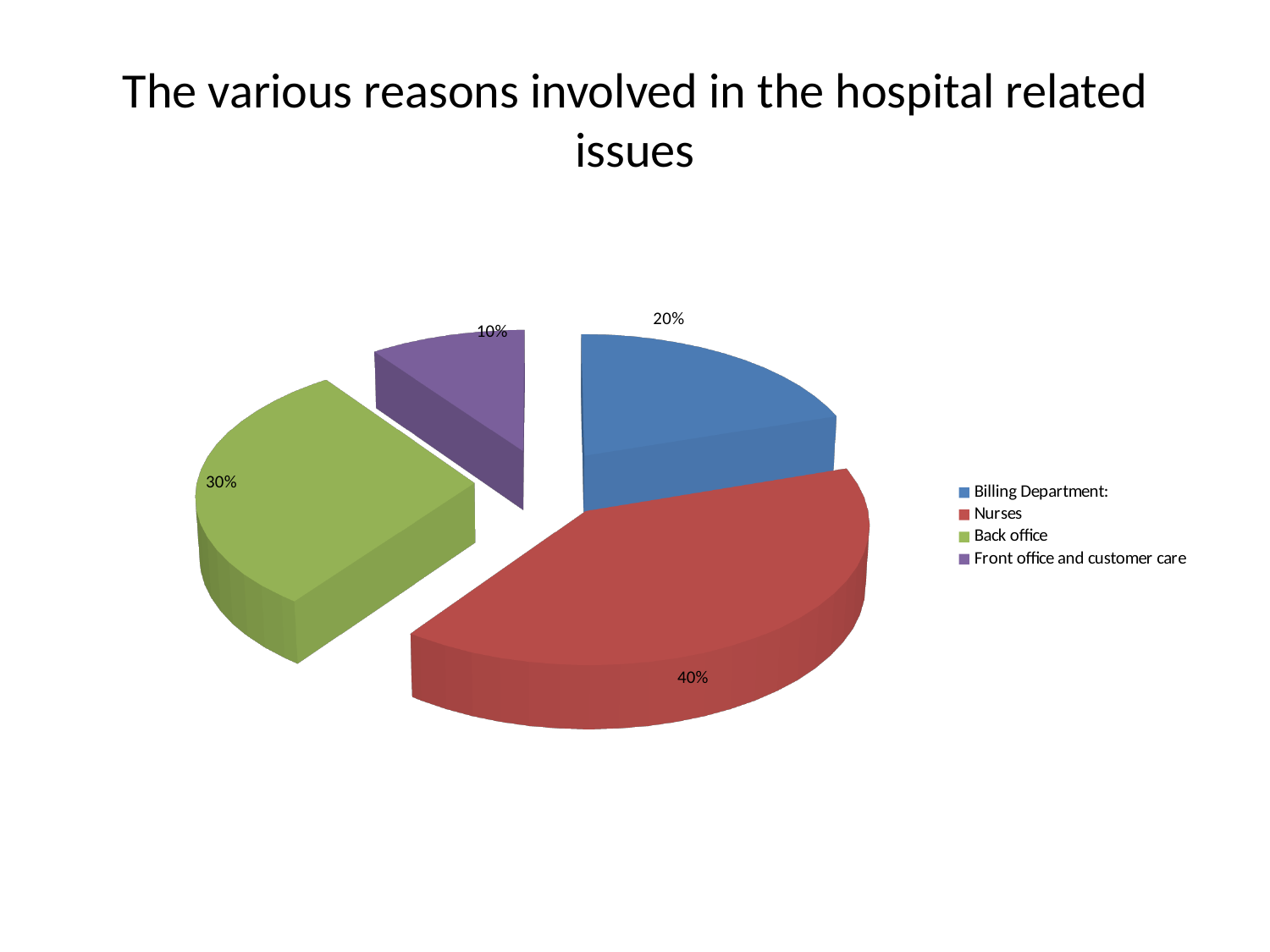
Which category has the largest slice of the pie? Nurses What share of the pie does Billing Department account for? 20% What is the difference in percentage points between Back office and Front office and customer care? 20% Which category has the smallest slice of the pie? Front office and customer care What share of the pie does Front office and customer care account for? 10% What share of the pie does Back office account for? 30% What kind of chart is shown on the slide? Pie chart Which is larger, the slice for Back office or the slice for Billing Department? Back office What is the difference in percentage points between Nurses and Billing Department? 20% How many categories does the pie chart show? 4 What colour is the slice for Nurses? Red